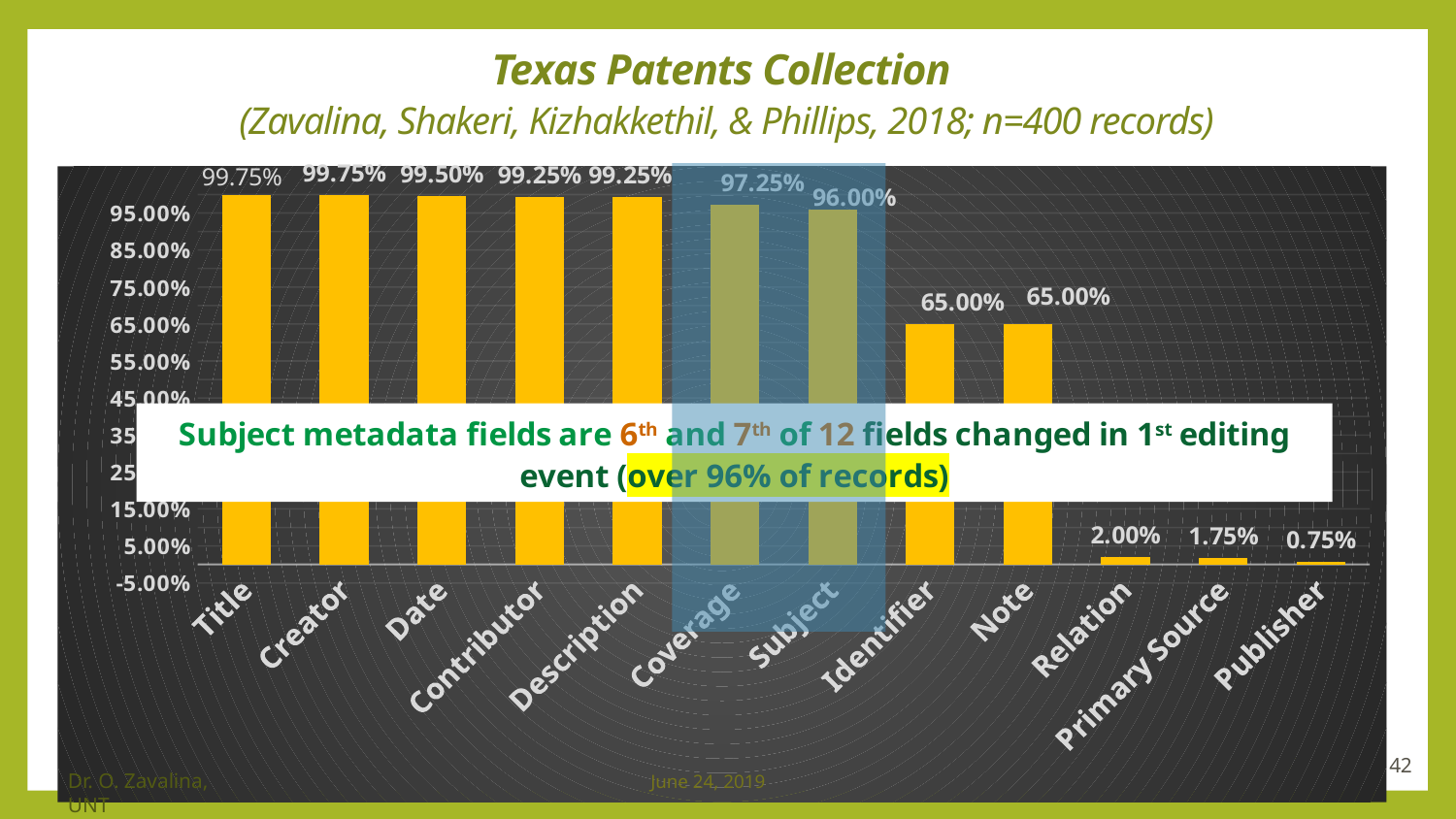
What is the difference between the values for Title and Note? 34.75% What is the value for Date? 99.50% Which category has the lowest value? Publisher Which is larger, the value for Relation or the value for Publisher? Relation Is the value for Note greater or less than 55.00%? greater What is the value for Primary Source? 1.75% What is the difference between the values for Coverage and Subject? 1.25% What is the value for Identifier? 65.00% What kind of chart is shown on the slide? bar chart How many categories are shown on the x axis? 12 Do the values generally rise or fall from left to right along the x axis? fall What is the value for Subject? 96.00%